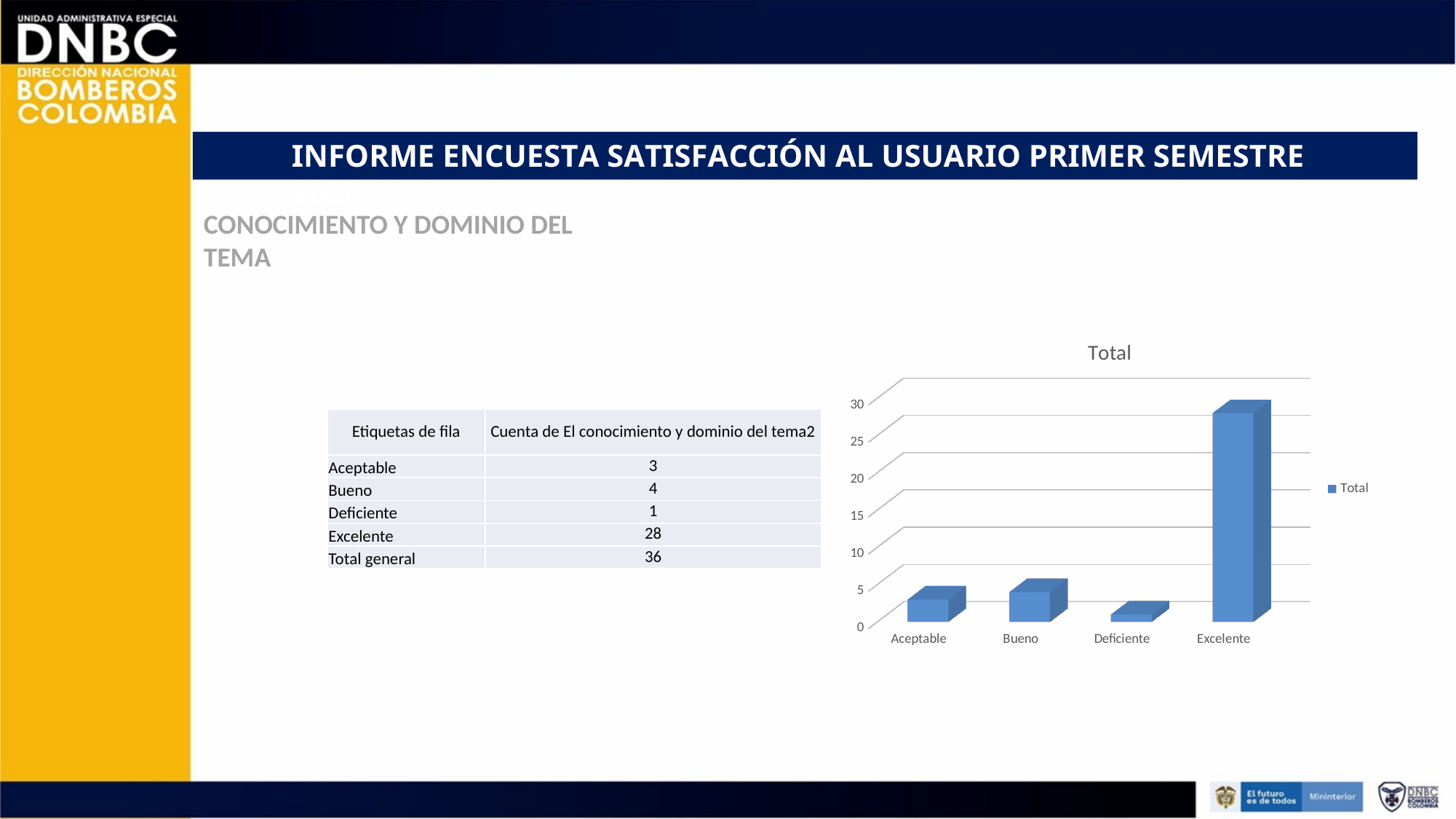
According to the table on the slide, what is the difference between the values for Excelente and Bueno? 24 Is the value for Excelente greater or less than 25? greater How many series does the chart legend list? 1 Which category has the highest value in the chart? Excelente How many categories are shown on the x axis of the chart? 4 According to the table on the slide, what is the value for Aceptable? 3 What is the title of the chart? Total What kind of chart is shown on the slide? bar chart Which is larger, the value for Bueno or the value for Aceptable? Bueno Is the value for Bueno greater or less than 5? less Which category has the lowest value in the chart? Deficiente According to the table on the slide, what is the value for Excelente? 28